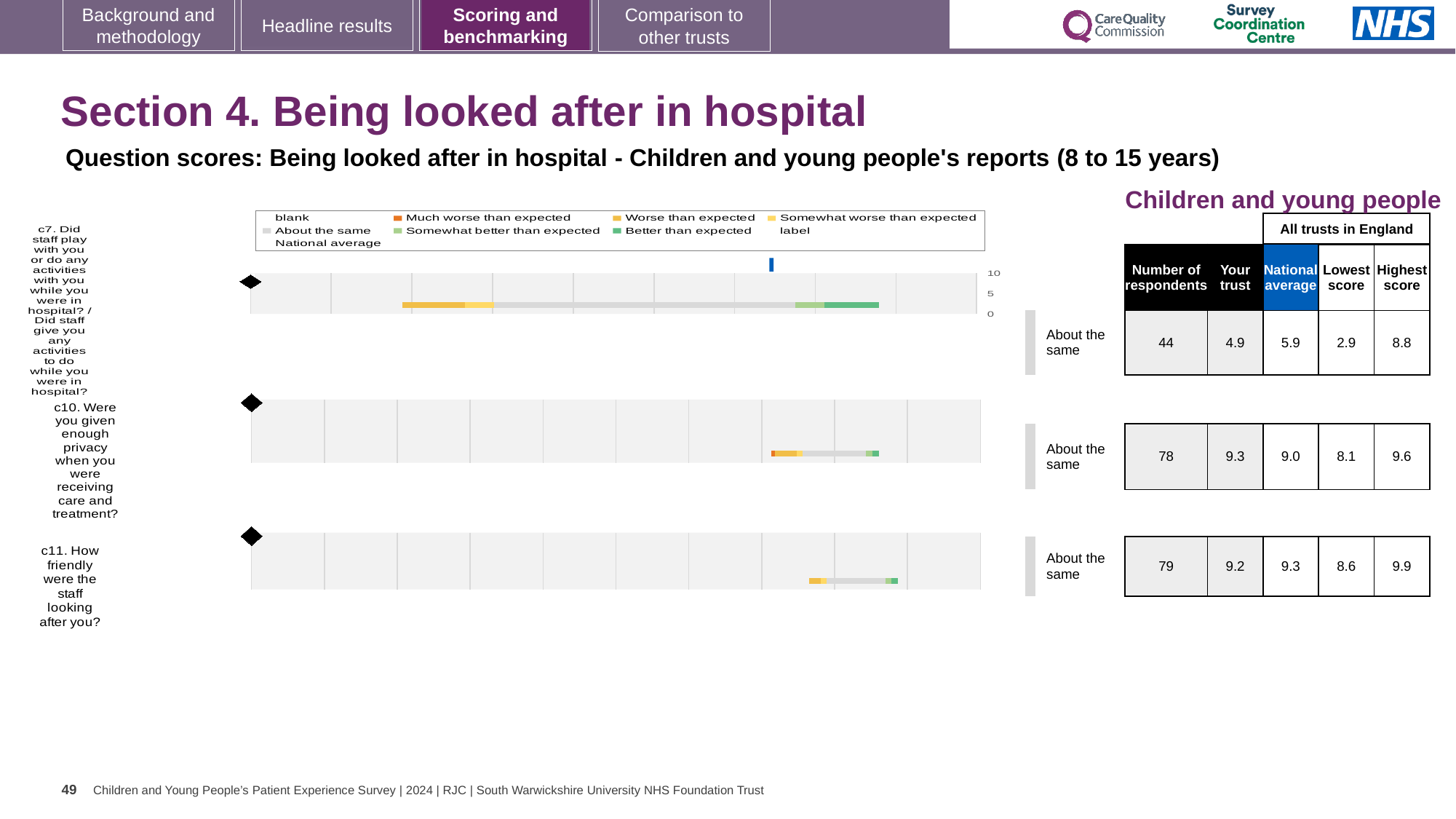
What is the lowest score among all trusts in England for c10? 8.1 What kind of chart is used to show the question scores on this slide? bar chart How many respondents answered c7 (Did staff play with you or do any activities with you while you were in hospital?)? 44 What benchmark category is shown for c11? About the same Which question has the lowest 'Your trust' score? c7 Which question has the highest 'Your trust' score? c10 What is the national average score for c11 (How friendly were the staff looking after you?)? 9.3 What is the 'Your trust' score for c10 (Were you given enough privacy when you were receiving care and treatment?)? 9.3 What colour does the legend use for 'Much worse than expected'? Orange For c7, which is larger: the 'Your trust' score or the national average? National average For c7, what is the difference between the highest score and the lowest score among all trusts in England? 5.9 How many survey questions are plotted on the slide? 3